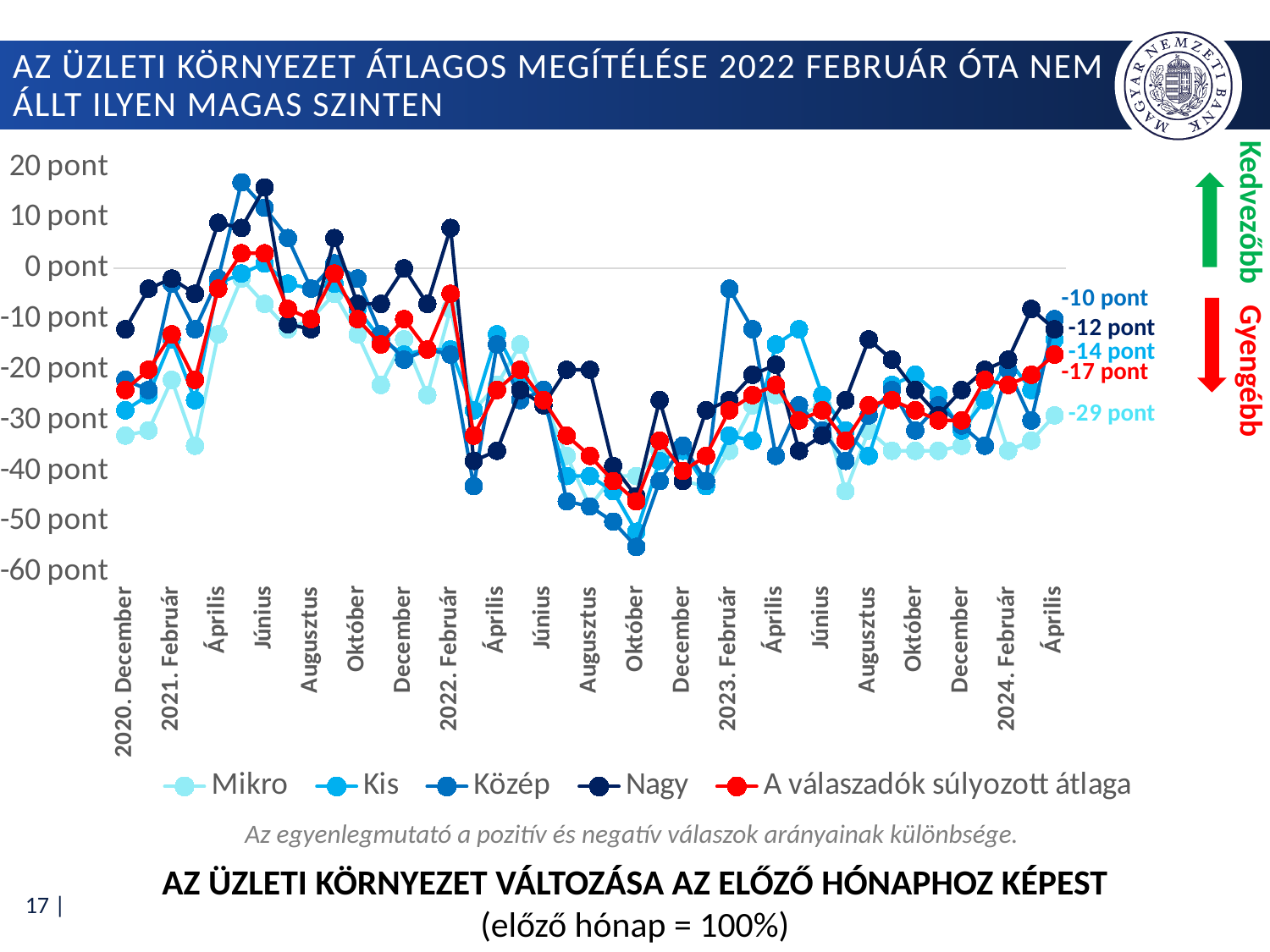
What is the latest value labelled for the Közép series? -10 pont What type of chart is shown on the slide? line chart Which series has the lowest labelled value at the end of the chart? Mikro Is the end-of-chart value for Nagy greater or less than -20 pont? greater What is the latest value labelled for 'A válaszadók súlyozott átlaga'? -17 pont Which series has the highest labelled value at the end of the chart? Közép What is the latest (2024 Április) value labelled for the Mikro series? -29 pont Which series is drawn in red? A válaszadók súlyozott átlaga What is the latest value labelled for the Nagy series? -12 pont What is the difference between the end-of-chart labelled values of Közép (-10 pont) and Mikro (-29 pont)? 19 pont How many series does the legend list? 5 What is the latest value labelled for the Kis series? -14 pont